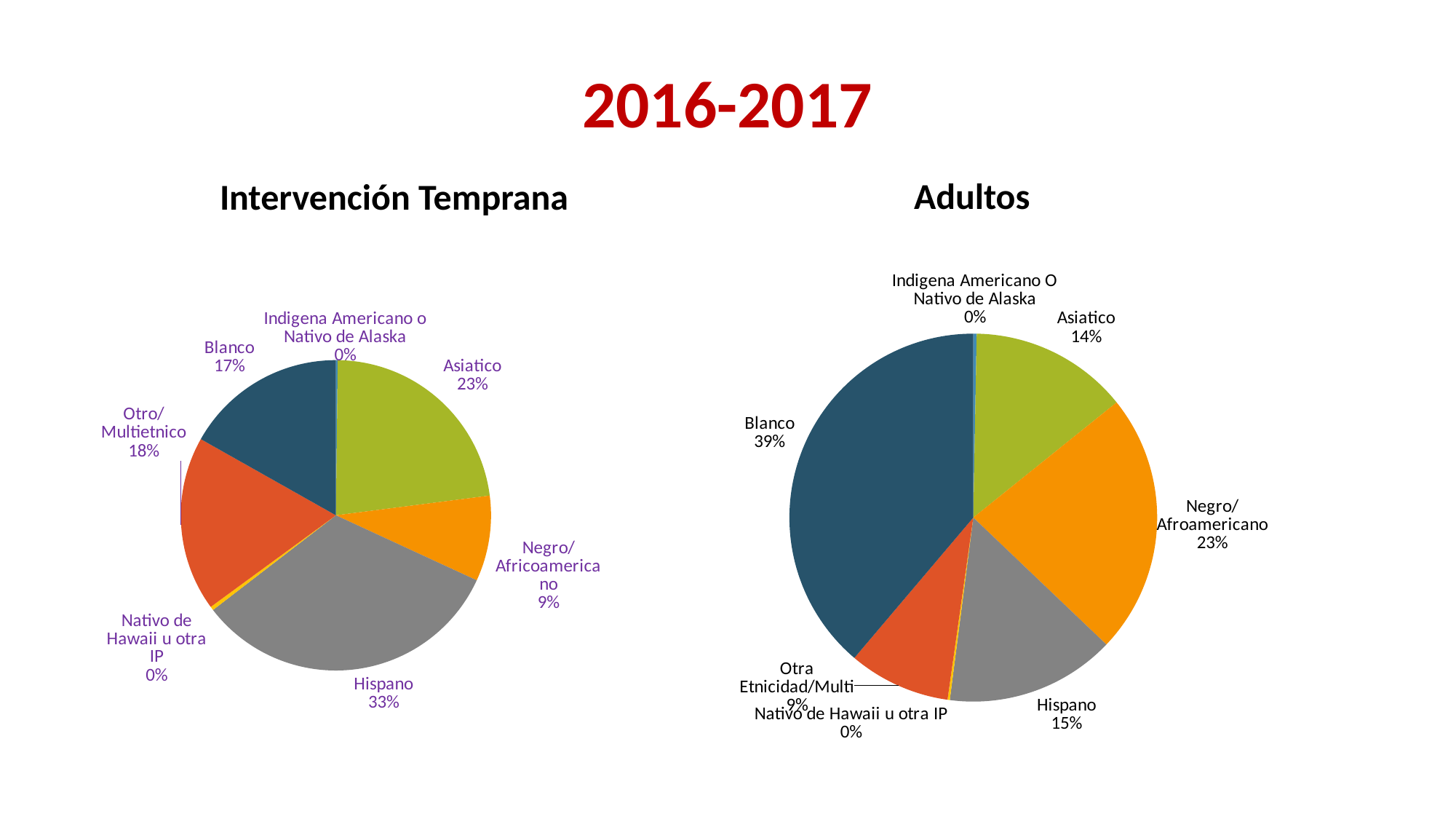
In the Adultos chart, what share is Otra Etnicidad/Multi? 9% In the Adultos chart, which is larger, Negro/Afroamericano or Asiatico? Negro/Afroamericano How many categories are labelled in the Intervención Temprana chart? 7 In the Intervención Temprana chart, which category has the largest share? Hispano What kind of chart is the Adultos chart? Pie chart In the Intervención Temprana chart, what share is Hispano? 33% What is the title shown at the top of the slide? 2016-2017 In the Intervención Temprana chart, what is the difference between the Asiatico share and the Negro/Africoamericano share? 14% In the Adultos chart, which category has the largest share? Blanco In the Adultos chart, what share is Blanco? 39% In the Intervención Temprana chart, which is larger, Otro/Multietnico or Blanco? Otro/Multietnico In the Adultos chart, what is the difference between the Blanco share and the Hispano share? 24%